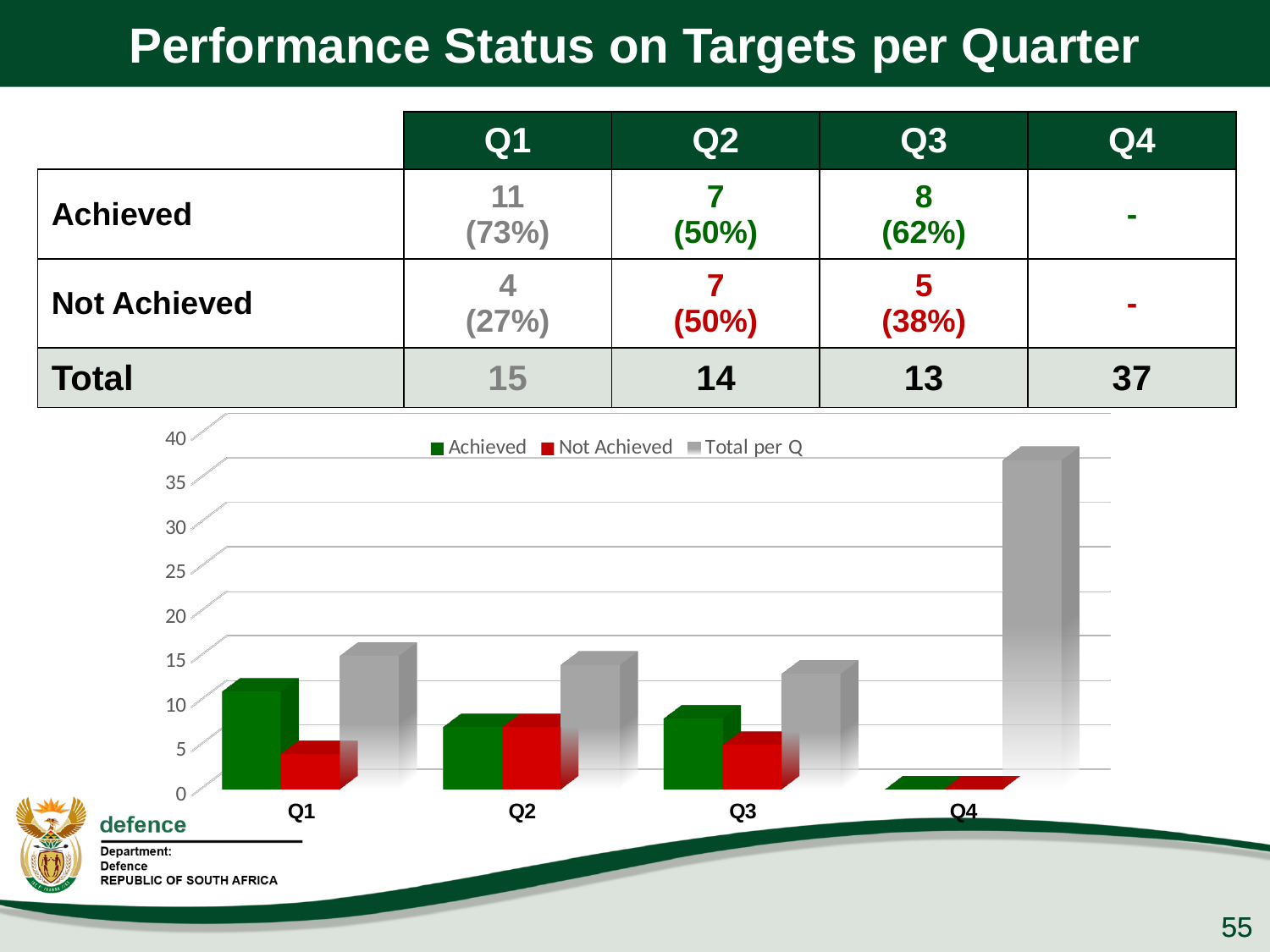
How many quarters are shown on the x axis of the chart? 4 What is the Total per Q value for Q4? 37 What kind of chart is shown on the slide? bar chart What is the Not Achieved value for Q3? 5 What is the Achieved value for Q1? 11 What is the difference between the Achieved and Not Achieved values for Q1? 7 Which series in the legend is shown in red? Not Achieved Is the Achieved bar for Q1 larger or smaller than the Achieved bar for Q2? larger Which quarter has the highest Total per Q bar? Q4 Is the Total per Q value for Q4 greater or less than 35? greater Which quarter has the lowest Not Achieved bar? Q4 How many series does the chart legend list? 3